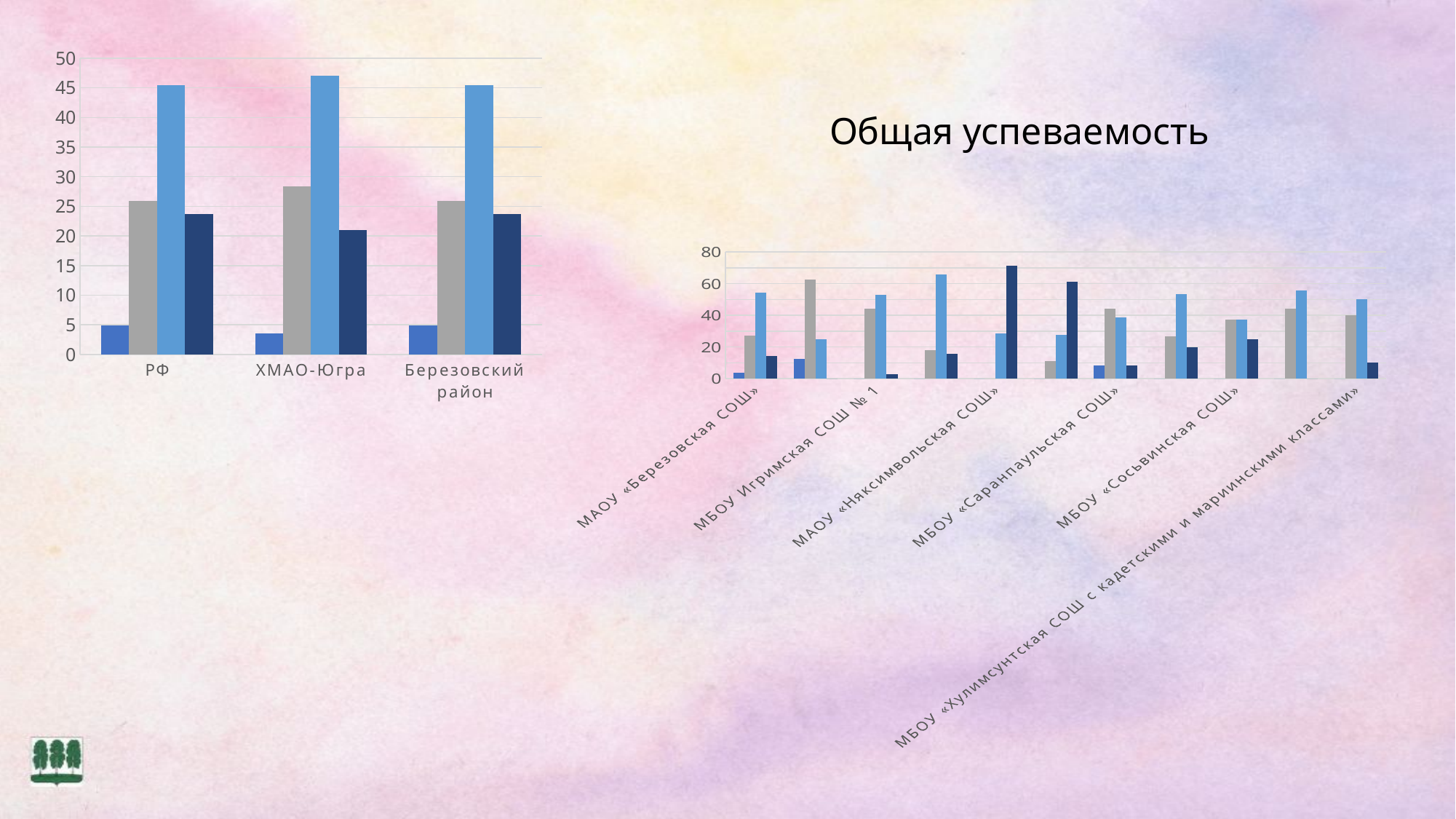
What is the title of the chart on the right of the slide? Общая успеваемость In the left chart, which category has the shortest first (dark blue) bar? ХМАО-Югра In the left chart, is the gray bar for РФ greater or less than 20? greater In the left chart, which category has the tallest light blue bar? ХМАО-Югра In the left chart, is the dark navy bar for ХМАО-Югра greater or less than 25? less What kind of chart is the chart on the left of the slide? bar chart How many categories are shown on the x axis of the left chart? 3 In the chart titled Общая успеваемость, is the tallest bar greater or less than 60? greater In the left chart, how many bars are plotted for each category? 4 In the left chart, is the gray bar for ХМАО-Югра larger or smaller than the dark navy bar for ХМАО-Югра? larger